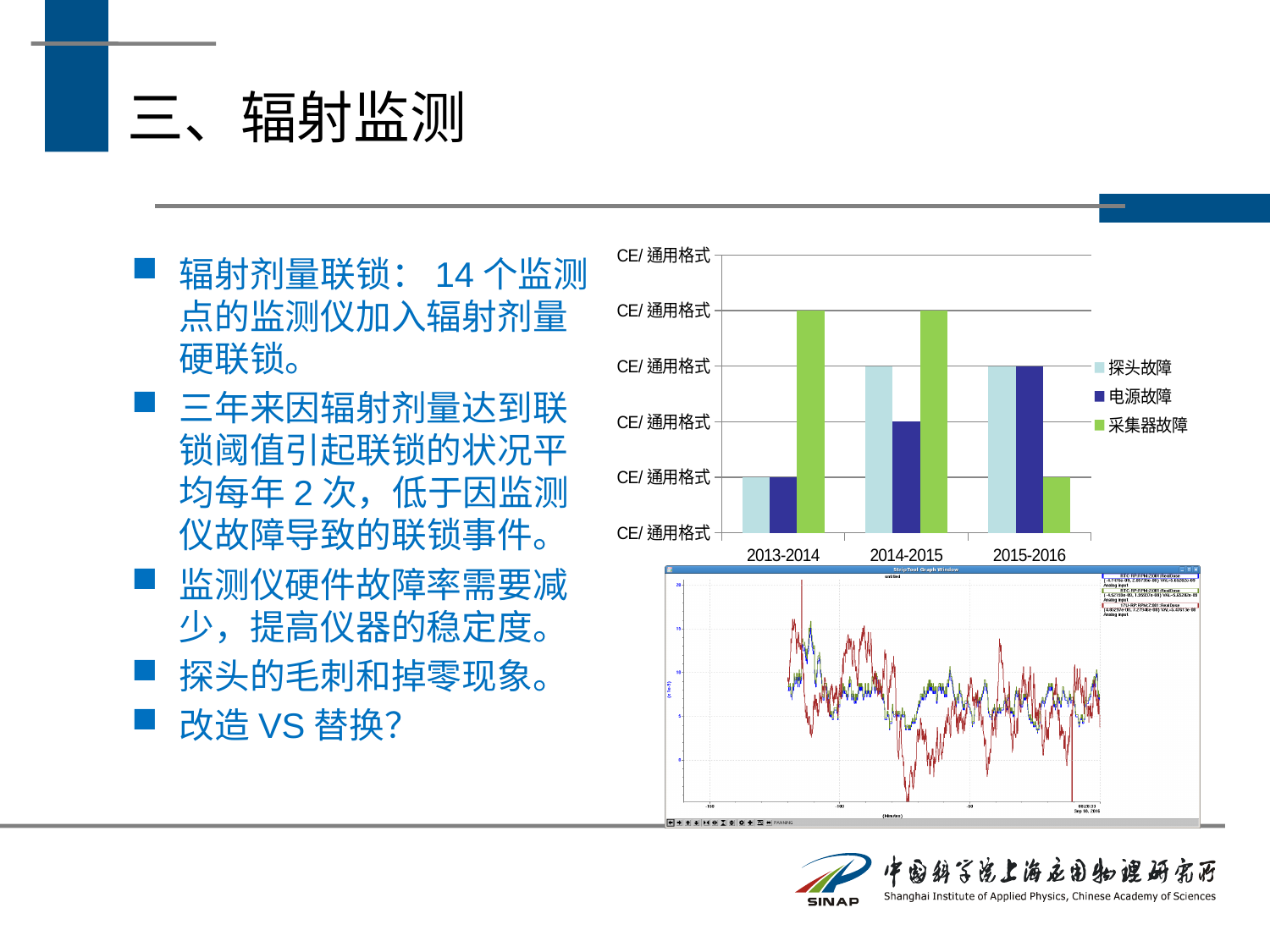
In the upper bar chart, how many year categories are shown on the x axis? 3 In the upper bar chart, for 2014-2015, which is larger: 探头故障 or 电源故障? 探头故障 In the upper bar chart, how many series does the legend list? 3 In the upper bar chart, is 采集器故障 larger in 2013-2014 or in 2015-2016? 2013-2014 What are the three legend entries of the upper bar chart? 探头故障, 电源故障, 采集器故障 In the upper bar chart, which series has the highest bar for 2013-2014? 采集器故障 In the upper bar chart, which series has the highest bar for 2014-2015? 采集器故障 In the upper bar chart, does the 电源故障 series rise or fall from 2013-2014 to 2015-2016? rise In the upper bar chart, which series has the lowest bar for 2015-2016? 采集器故障 What kind of chart is shown in the StripTool Graph Window at the bottom right of the slide? line chart What kind of chart is the upper chart on the right of the slide? bar chart In the upper bar chart, is 探头故障 larger in 2013-2014 or in 2014-2015? 2014-2015